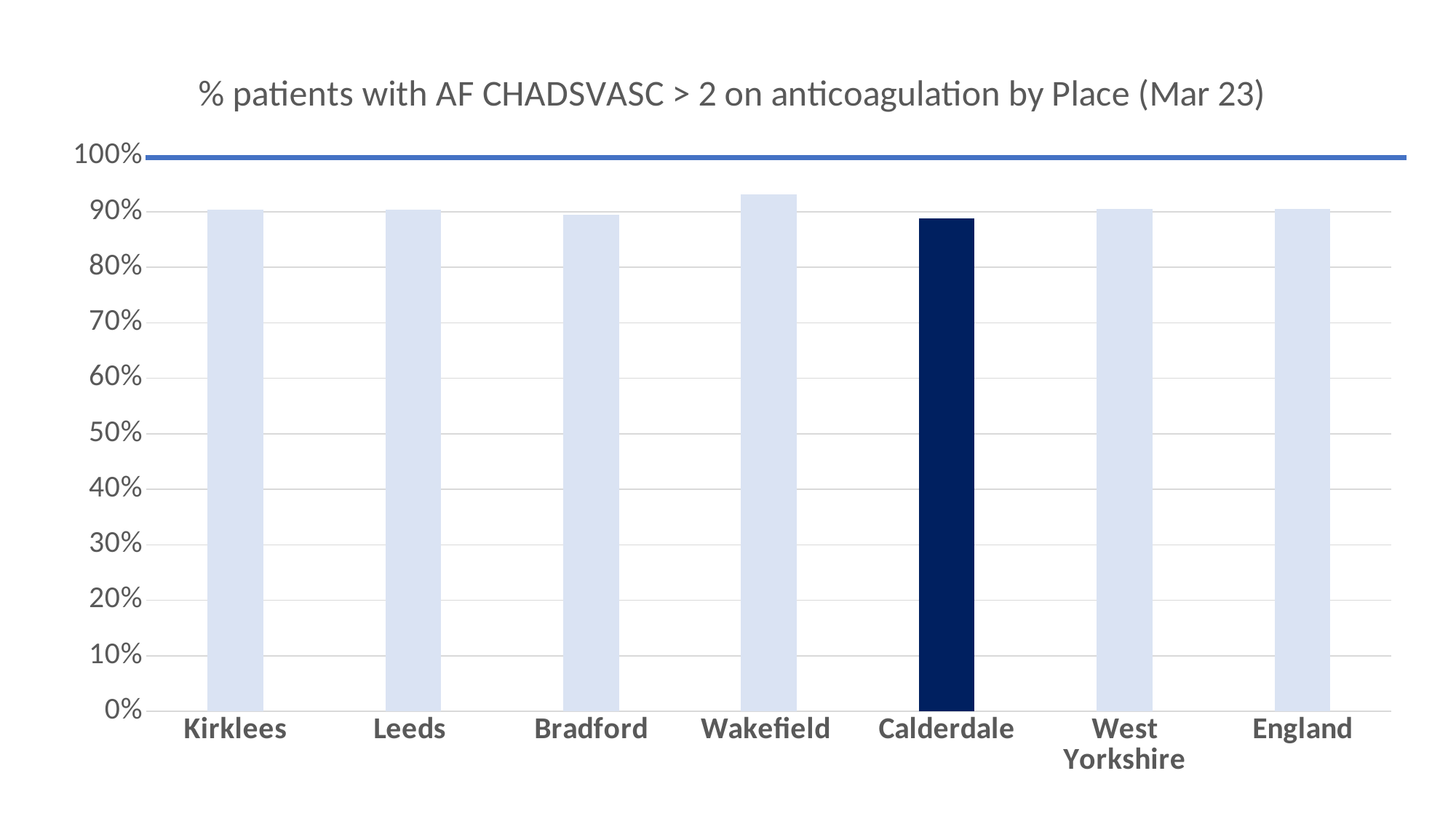
Is the value for Wakefield greater or less than 90%? greater Is the value for Calderdale greater or less than 90%? less Is the value for Kirklees greater or less than 80%? greater Which place has the highest percentage of AF patients with CHADSVASC > 2 on anticoagulation? Wakefield How many places (categories) are plotted on the chart? 7 What is the title of the chart? % patients with AF CHADSVASC > 2 on anticoagulation by Place (Mar 23) Which place's bar is shown in dark navy blue rather than light blue? Calderdale What kind of chart is shown on the slide? bar chart Which is larger, the value for Wakefield or the value for Calderdale? Wakefield